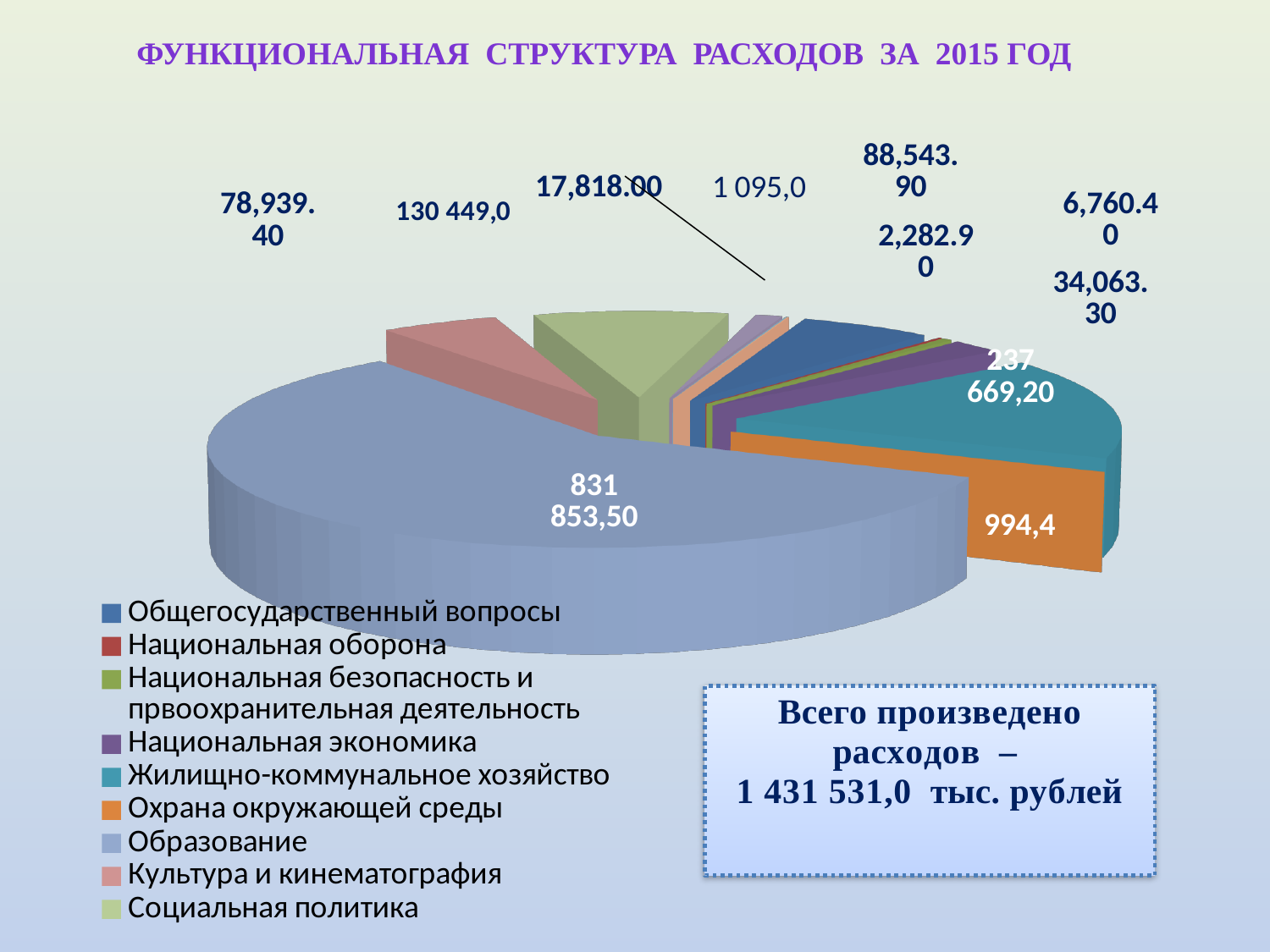
What value is labelled on the largest slice of the pie chart (Образование)? 831 853,50 Which legend entry is shown in orange? Охрана окружающей среды According to the text box on the slide, what is the total amount of expenditures? 1 431 531,0 тыс. рублей What is the title of the chart on the slide? ФУНКЦИОНАЛЬНАЯ СТРУКТУРА РАСХОДОВ ЗА 2015 ГОД What kind of chart is shown on the slide? pie chart Which category has the largest slice of the pie chart? Образование Which slice is larger: Образование or Социальная политика? Образование Which slice is larger: Образование or Культура и кинематография? Образование How many categories does the legend of the pie chart list? 9